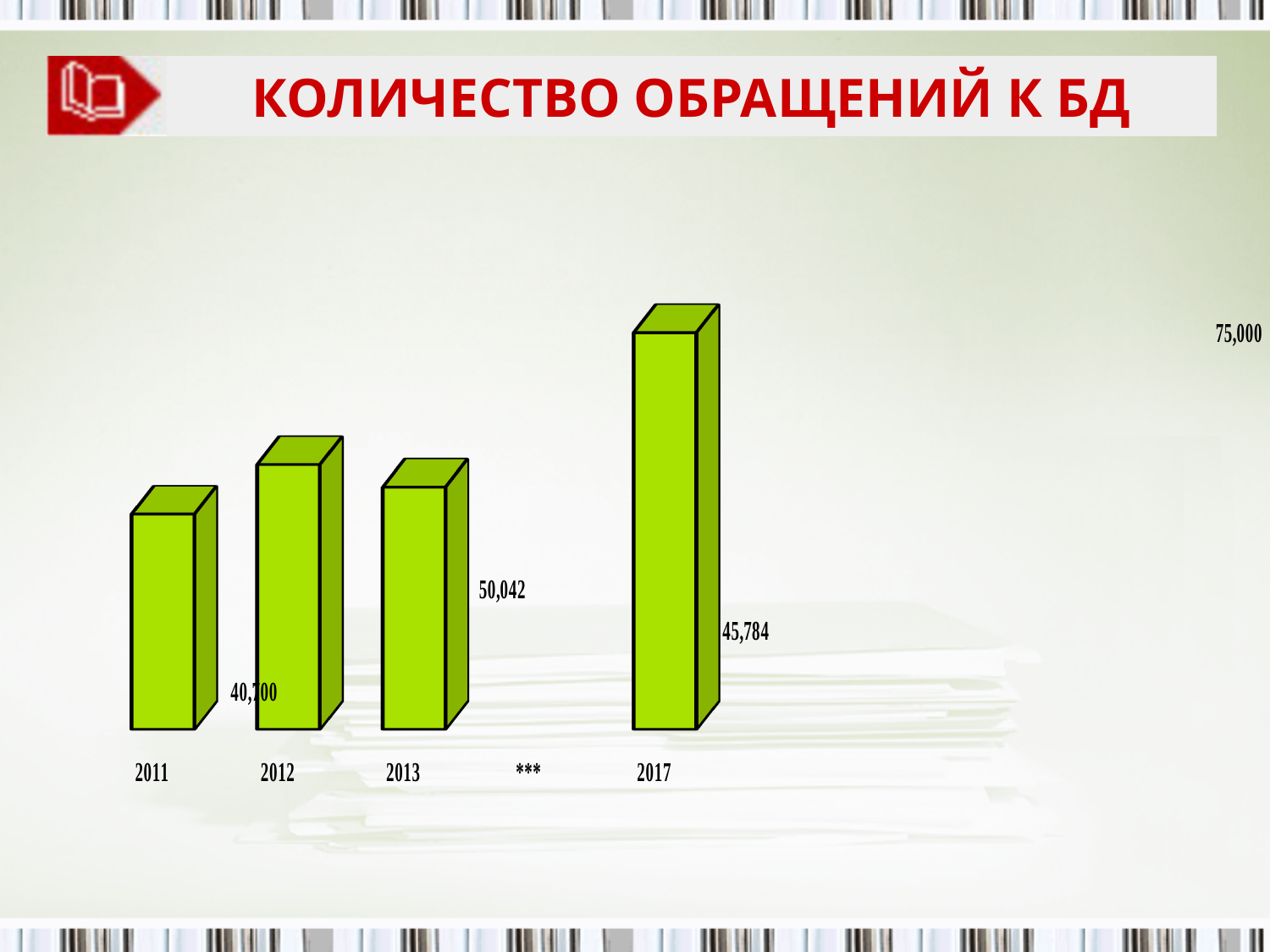
Which bar is taller, 2012 or 2013? 2012 Does the bar for 2017 rise or fall compared with the bar for 2013? rise Which year has the shortest bar? 2011 How many category labels are shown along the x axis? 5 What kind of chart is shown on the slide? bar chart Which year has the tallest bar? 2017 What is the largest data label printed on the chart? 75,000 How many bars are plotted in the chart? 4 What colour are the bars in the chart? green What is the title of the slide chart? КОЛИЧЕСТВО ОБРАЩЕНИЙ К БД Which bar is taller, 2011 or 2013? 2013 Does the value rise or fall from 2012 to 2013? fall